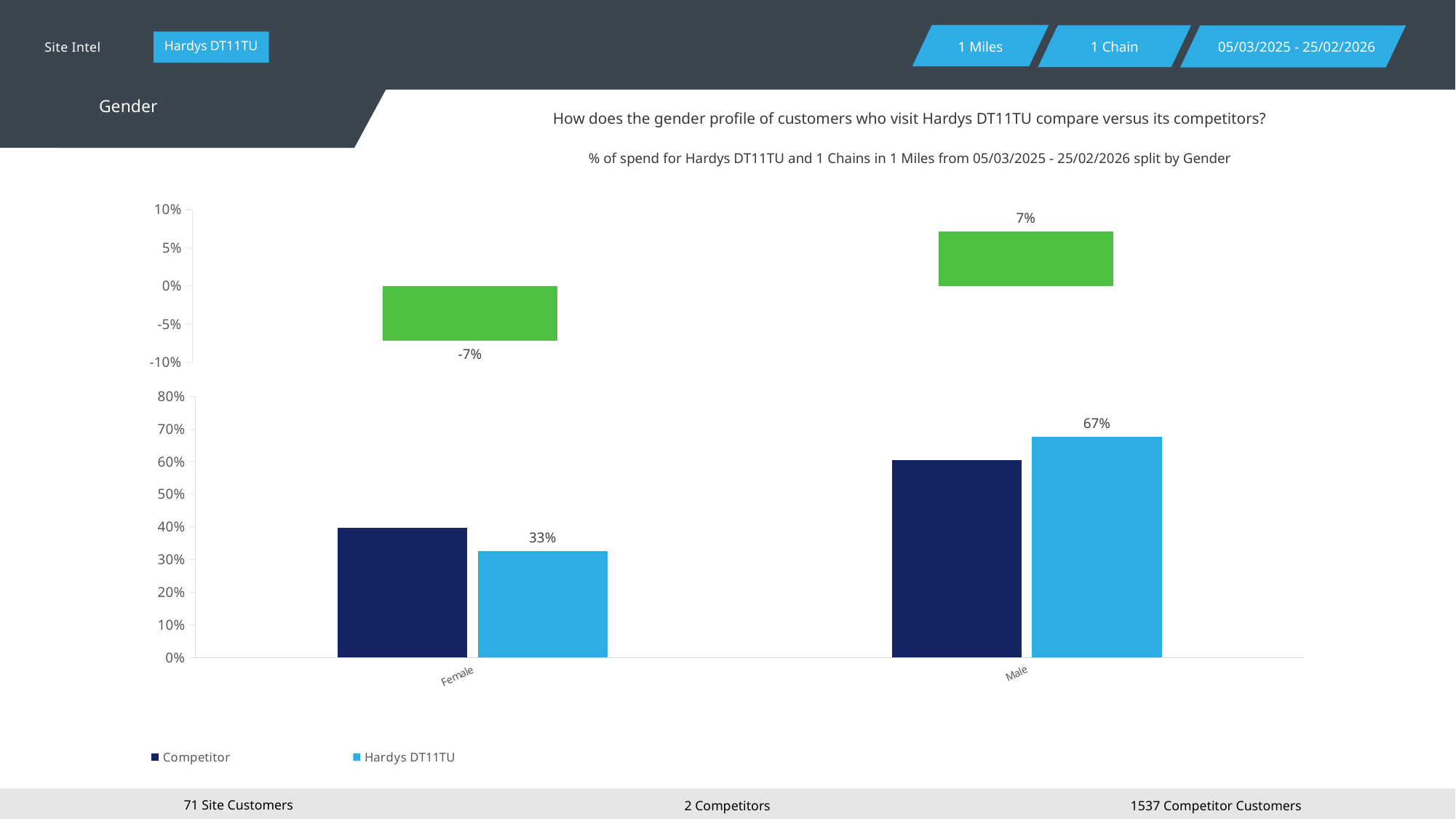
In the bottom chart, which gender has the higher value for Hardys DT11TU? Male In the bottom chart, what is the difference between the Hardys DT11TU values for Male and Female? 34% In the top chart, what is the value shown for Female? -7% In the bottom chart, is the Competitor value for Female greater or less than 50%? less What type of chart is the bottom chart? Bar chart In the bottom chart, what is the value for Hardys DT11TU for Male? 67% In the bottom chart, for Female, which is larger: the Competitor bar or the Hardys DT11TU bar? Competitor In the top chart, what is the value shown for Male? 7% How many series does the legend of the bottom chart list? 2 In the bottom chart, for Male, which is larger: the Competitor bar or the Hardys DT11TU bar? Hardys DT11TU In the bottom chart, is the Competitor value for Male greater or less than 50%? greater In the bottom chart, what is the value for Hardys DT11TU for Female? 33%